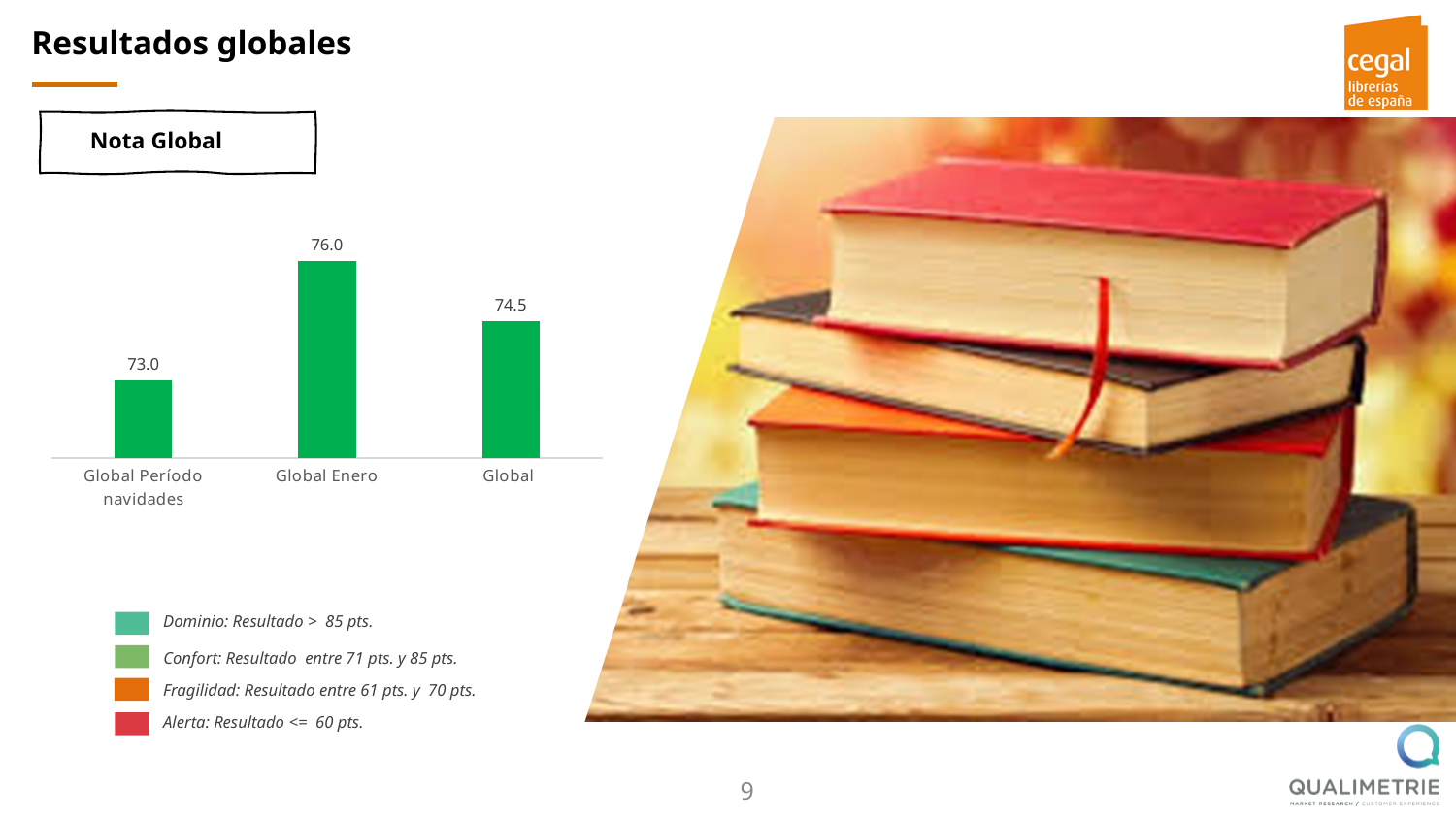
What is the difference between the values for Global Enero and Global Período navidades? 3.0 Which is larger, the value for Global or the value for Global Período navidades? Global What is the title of the chart? Nota Global What is the value for Global Enero? 76.0 Which category has the highest value? Global Enero What is the difference between the values for Global Enero and Global? 1.5 How many categories are shown in the chart? 3 What kind of chart is shown on the slide? bar chart What colour are the bars in the chart? green What is the value for Global Período navidades? 73.0 Which category has the lowest value? Global Período navidades What is the value for Global? 74.5